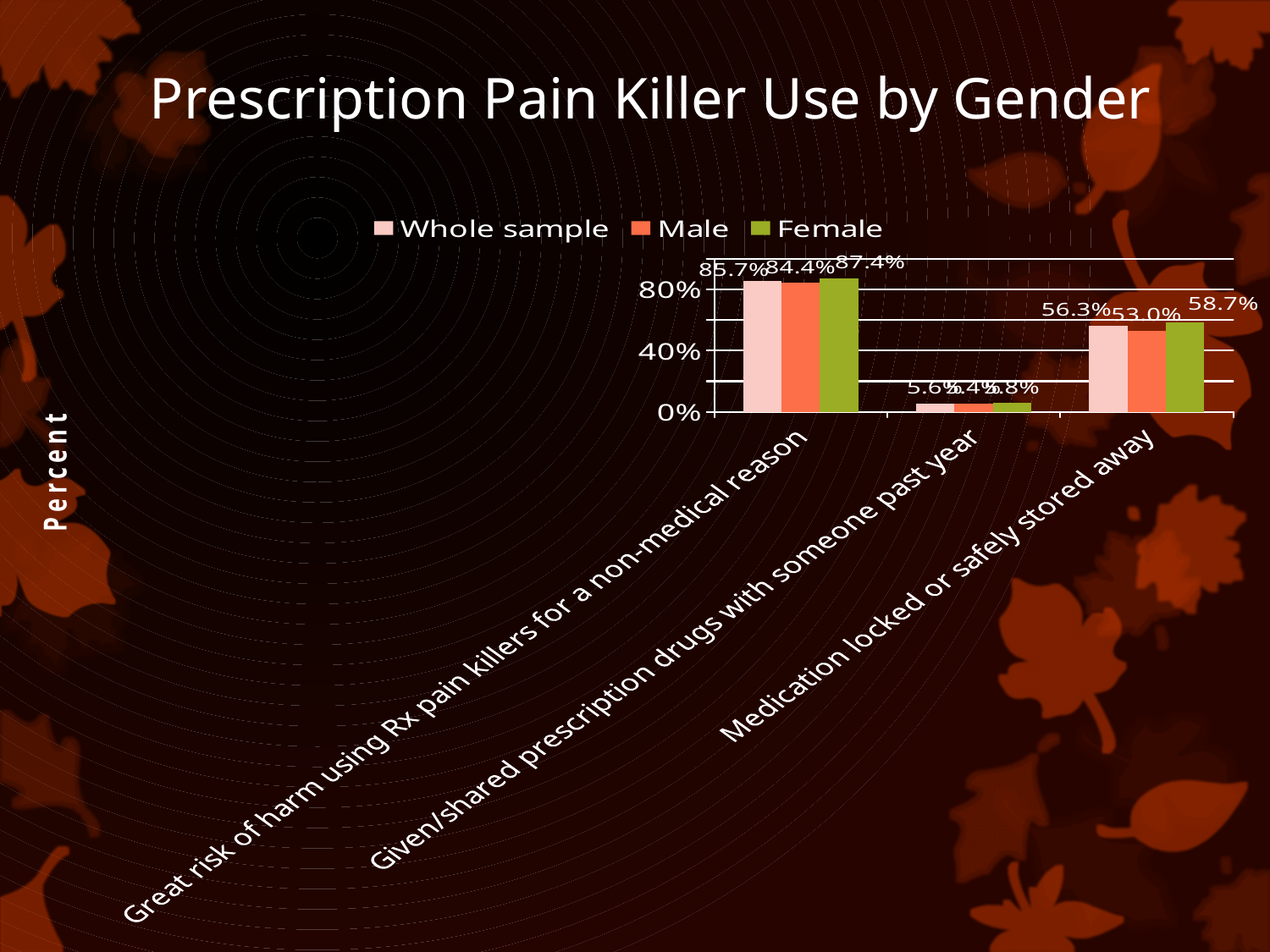
How many series does the legend list? 3 What kind of chart is shown on the slide? bar chart For 'Great risk of harm using Rx pain killers for a non-medical reason', which is larger: the Male value or the Female value? Female What is the value for Whole sample in the category 'Great risk of harm using Rx pain killers for a non-medical reason'? 85.7% Is the Male value for 'Medication locked or safely stored away' greater or less than 40%? greater Which category has the lowest value for the Whole sample series? Given/shared prescription drugs with someone past year What is the value for Female in the category 'Medication locked or safely stored away'? 58.7% What is the difference between the Female and Male values for 'Medication locked or safely stored away'? 5.7% How many categories are shown on the x axis of the chart? 3 Which category has the highest value for the Female series? Great risk of harm using Rx pain killers for a non-medical reason What is the value for Female in the category 'Great risk of harm using Rx pain killers for a non-medical reason'? 87.4% What is the value for Male in the category 'Medication locked or safely stored away'? 53.0%